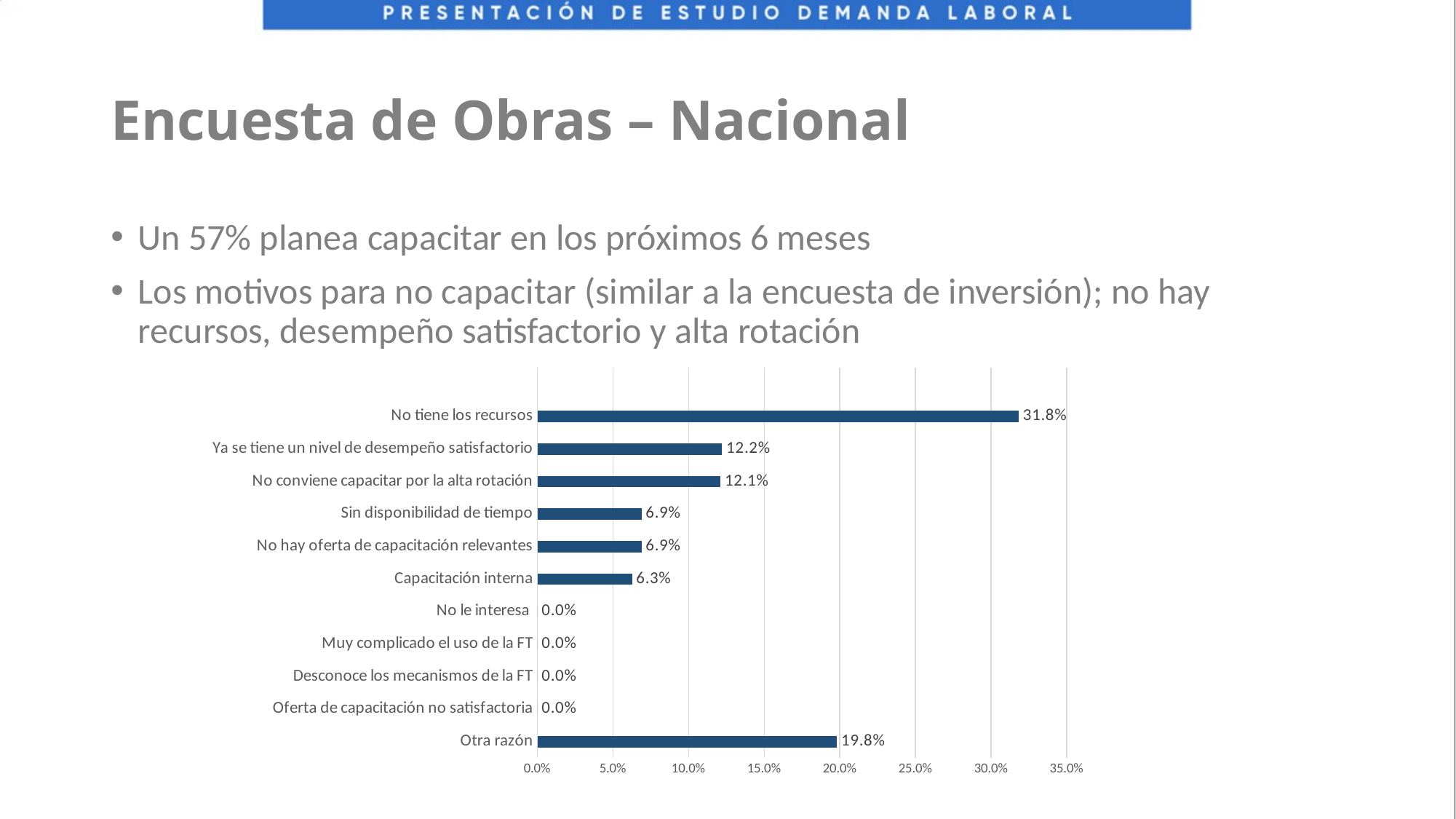
What is the value for "Capacitación interna"? 6.3% What is the difference between "Ya se tiene un nivel de desempeño satisfactorio" and "Capacitación interna"? 5.9% Is the value for "No tiene los recursos" greater or less than 30.0%? greater What is the value for "No tiene los recursos"? 31.8% How many categories have a value of 0.0%? 4 How many categories are shown in the chart? 11 What kind of chart is shown on the slide? Bar chart What is the value for "No conviene capacitar por la alta rotación"? 12.1% Which is larger, "Otra razón" or "Sin disponibilidad de tiempo"? Otra razón What is the difference between "No tiene los recursos" and "Otra razón"? 12.0% Which category has the highest value? No tiene los recursos What is the value for "Otra razón"? 19.8%